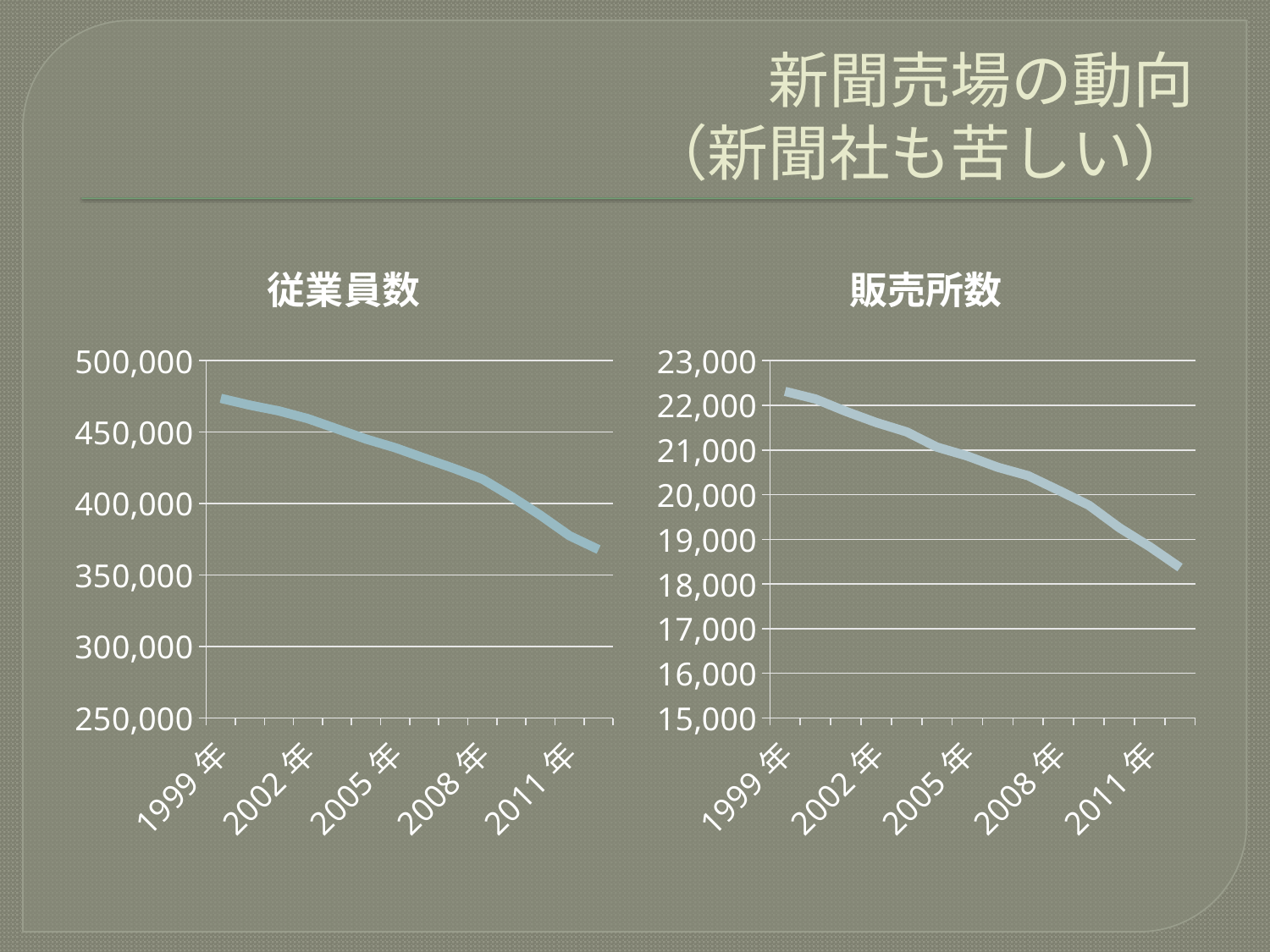
In the 従業員数 chart, which labeled year has the lowest value? 2011年 What is the title of the chart on the right side of the slide? 販売所数 In the 販売所数 chart, is the value for 2002年 greater or less than 21,000? greater In the 販売所数 chart, is the value for 1999年 greater or less than 22,000? greater In the 従業員数 chart, do the values rise or fall from 1999年 to 2011年? fall In the 従業員数 chart, is the value for 1999年 greater or less than 450,000? greater In the 販売所数 chart, which labeled year has the highest value? 1999年 In the 販売所数 chart, do the values rise or fall from 1999年 to 2011年? fall What kind of chart is the 従業員数 chart? line chart